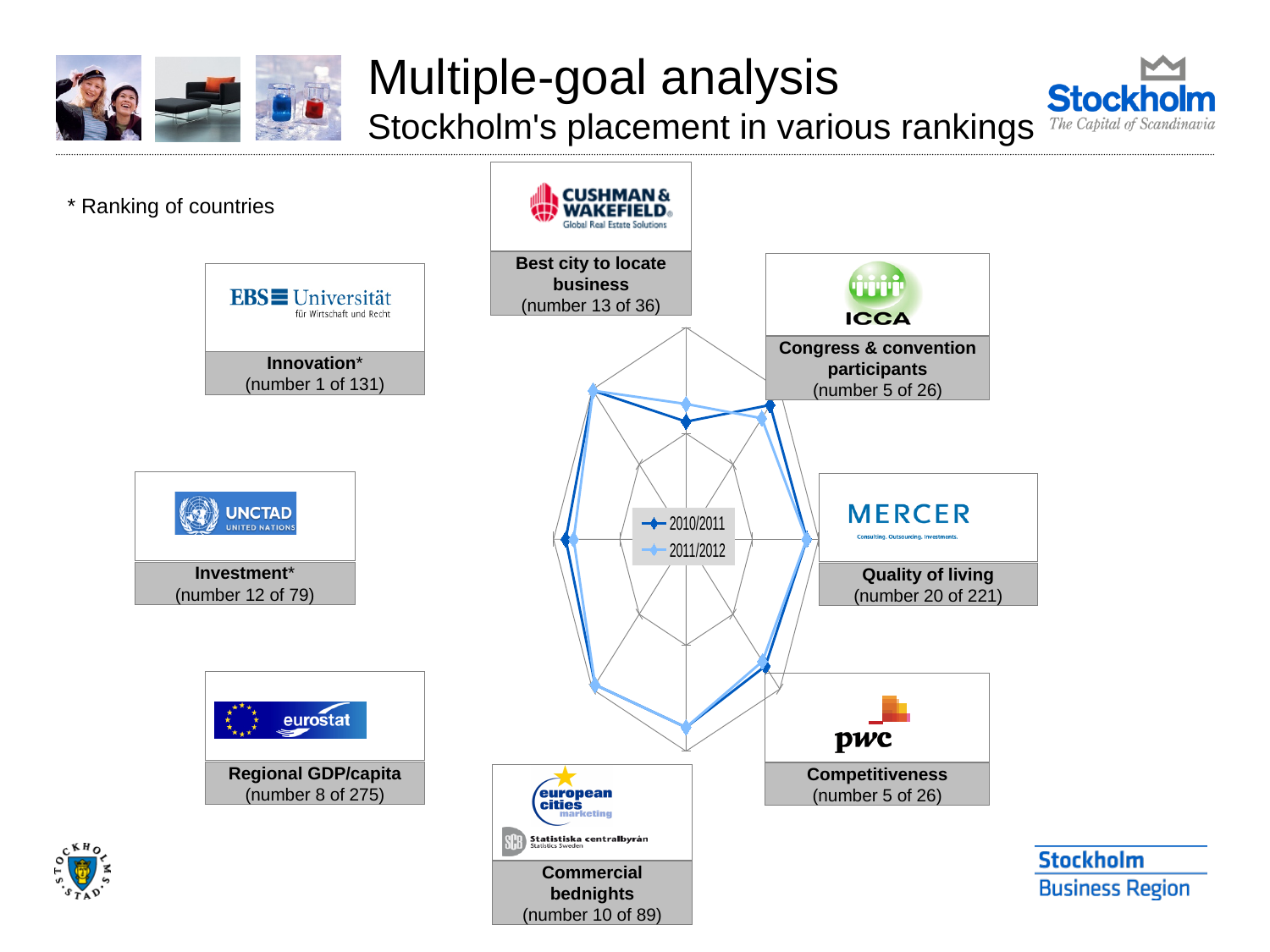
What is Stockholm's placement in the Investment ranking shown on the slide? number 12 of 79 What is Stockholm's placement in the Competitiveness ranking shown on the slide? number 5 of 26 How many series does the chart's legend list? 2 What kind of chart is shown on the slide? Radar chart Which two periods are listed in the chart's legend? 2010/2011 and 2011/2012 What is Stockholm's placement in the Quality of living ranking shown on the slide? number 20 of 221 What is the main title of the slide containing the chart? Multiple-goal analysis How many ranking categories (axes) does the radar chart have? 8 What is Stockholm's placement in the Regional GDP/capita ranking shown on the slide? number 8 of 275 What is Stockholm's placement in the Innovation ranking shown on the slide? number 1 of 131 What is Stockholm's placement in the Commercial bednights ranking shown on the slide? number 10 of 89 What is Stockholm's placement in the Best city to locate business ranking shown on the slide? number 13 of 36